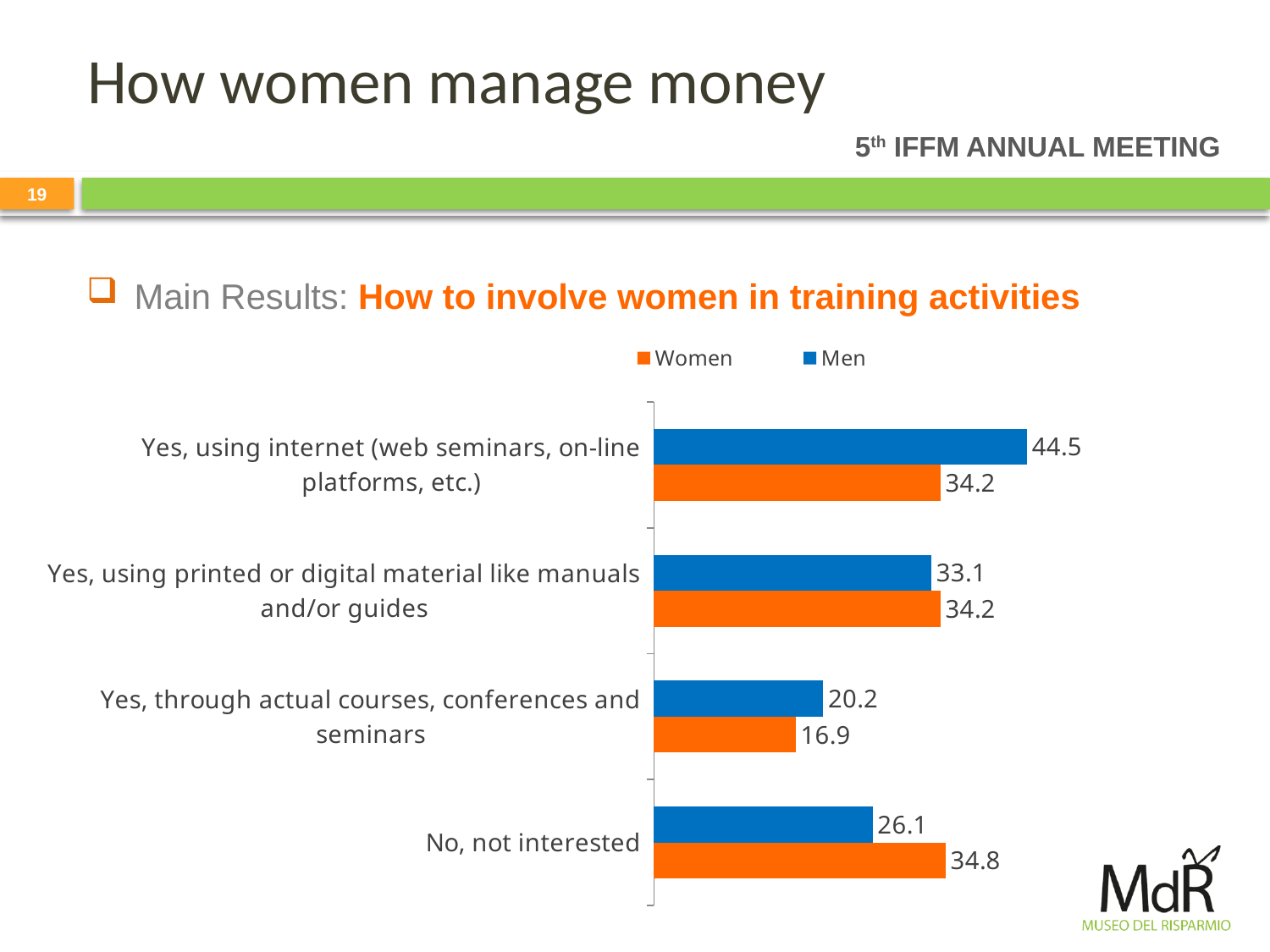
What is the value for Men for "Yes, using internet (web seminars, on-line platforms, etc.)"? 44.5 For "Yes, through actual courses, conferences and seminars", which series has the larger value, Women or Men? Men How many series does the legend list? 2 What is the value for Women for "No, not interested"? 34.8 What is the difference between the Men and Women values for "Yes, using internet (web seminars, on-line platforms, etc.)"? 10.3 What kind of chart is shown on the slide? Bar chart Which category has the highest value for Men? Yes, using internet (web seminars, on-line platforms, etc.) What is the value for Women for "Yes, through actual courses, conferences and seminars"? 16.9 What is the value for Men for "Yes, using printed or digital material like manuals and/or guides"? 33.1 Which category has the lowest value for Women? Yes, through actual courses, conferences and seminars What is the difference between the Women and Men values for "No, not interested"? 8.7 How many categories are shown in the chart? 4